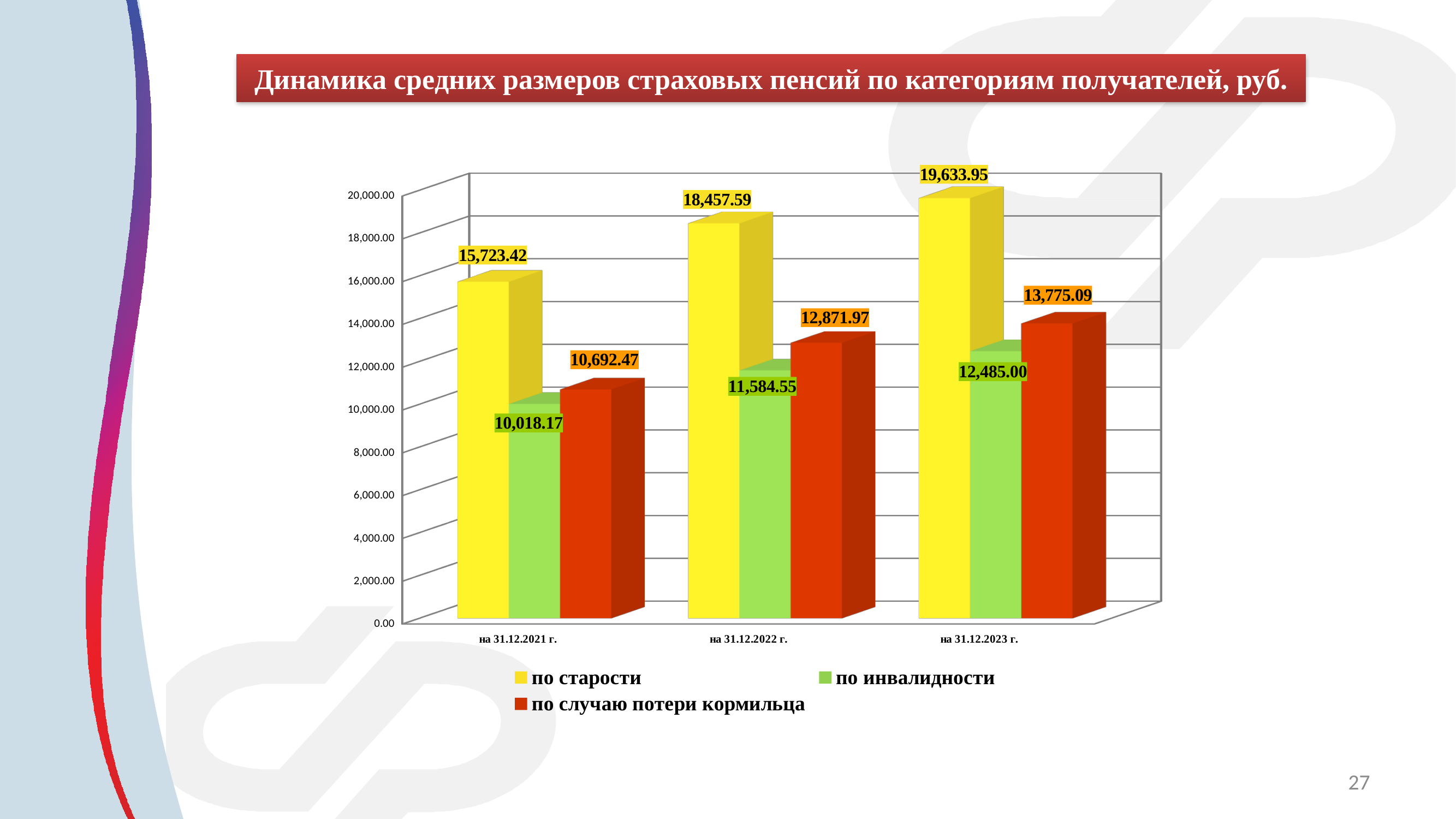
How many periods are shown on the x axis? 3 What is the value for "по старости" on 31.12.2021? 15,723.42 Which is larger on 31.12.2022: "по инвалидности" or "по случаю потери кормильца"? по случаю потери кормильца Do the values for "по старости" rise or fall from 31.12.2021 to 31.12.2023? rise In which period is the value for "по старости" highest? на 31.12.2023 г. What kind of chart is shown on the slide? bar chart In which period is the value for "по инвалидности" lowest? на 31.12.2021 г. What is the difference between the "по старости" values on 31.12.2023 and 31.12.2021? 3,910.53 How many series does the legend list? 3 What is the value for "по случаю потери кормильца" on 31.12.2022? 12,871.97 What is the value for "по инвалидности" on 31.12.2023? 12,485.00 What is the difference between "по случаю потери кормильца" and "по инвалидности" on 31.12.2023? 1,290.09